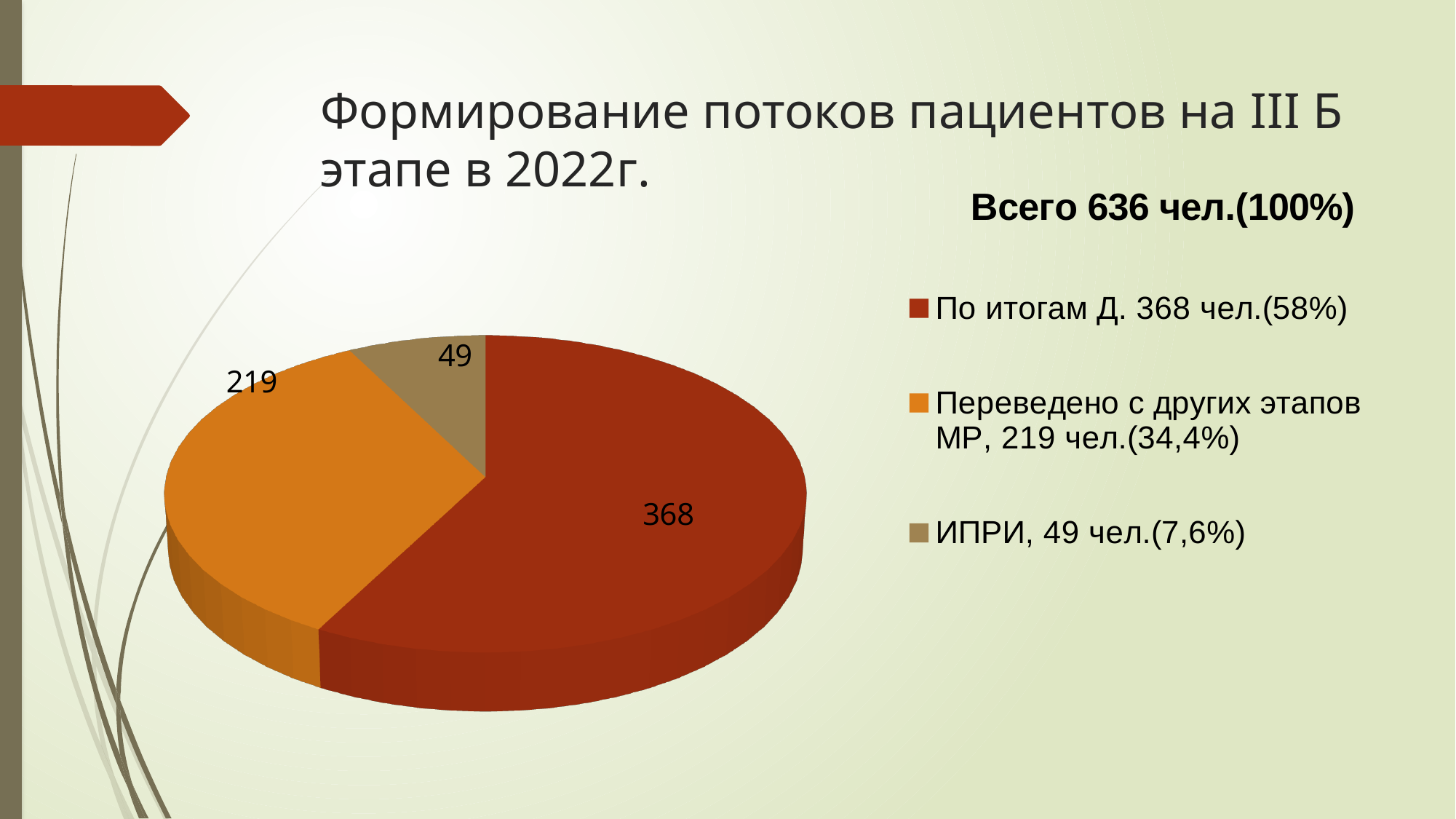
What is the value of the slice labelled 'Переведено с других этапов МР'? 219 What is the difference between the 'По итогам Д.' slice and the 'Переведено с других этапов МР' slice? 149 What total number of people is stated above the legend? 636 чел.(100%) Which category has the largest slice? По итогам Д. What is the value of the slice labelled 'ИПРИ'? 49 How many entries does the legend list? 3 What share of the pie does the 'ИПРИ' slice represent, as shown in the legend? 7,6% Which category has the smallest slice? ИПРИ How many slices does the pie chart have? 3 What type of chart is shown on the slide? pie chart Which is larger: the 'Переведено с других этапов МР' slice or the 'ИПРИ' slice? Переведено с других этапов МР What is the value of the slice labelled 'По итогам Д.'? 368